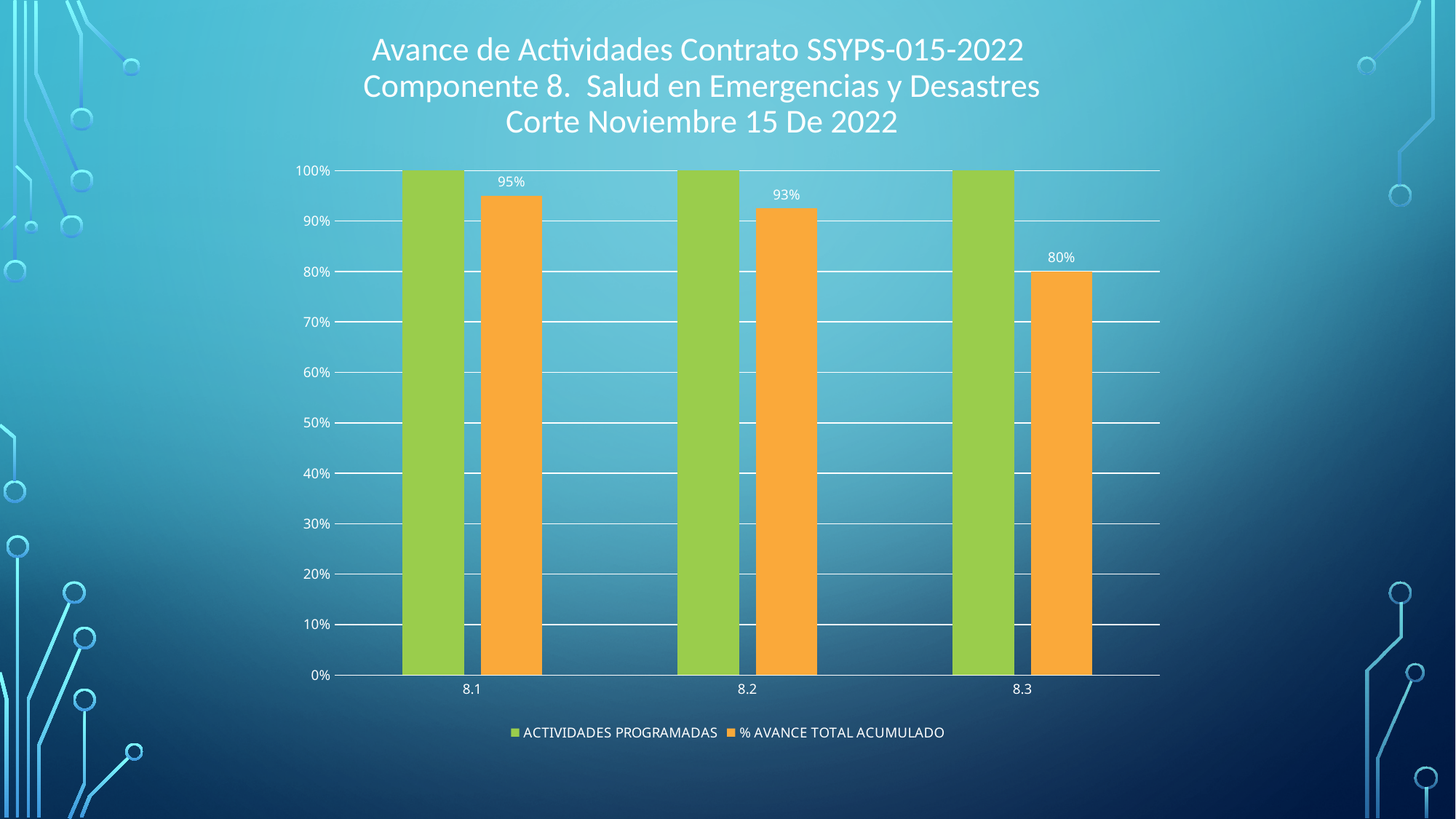
Which category has the lowest % AVANCE TOTAL ACUMULADO? 8.3 How many categories are shown on the x axis? 3 Which category has the highest % AVANCE TOTAL ACUMULADO? 8.1 What is the ACTIVIDADES PROGRAMADAS value for category 8.2? 100% Is the % AVANCE TOTAL ACUMULADO for 8.3 greater or less than 90%? less What is the % AVANCE TOTAL ACUMULADO value for category 8.1? 95% How many series does the legend list? 2 What kind of chart is shown on the slide? bar chart What is the % AVANCE TOTAL ACUMULADO value for category 8.2? 93% What is the difference between the % AVANCE TOTAL ACUMULADO values for 8.1 and 8.3? 15% What is the % AVANCE TOTAL ACUMULADO value for category 8.3? 80% Which is larger, the % AVANCE TOTAL ACUMULADO for 8.2 or for 8.3? 8.2